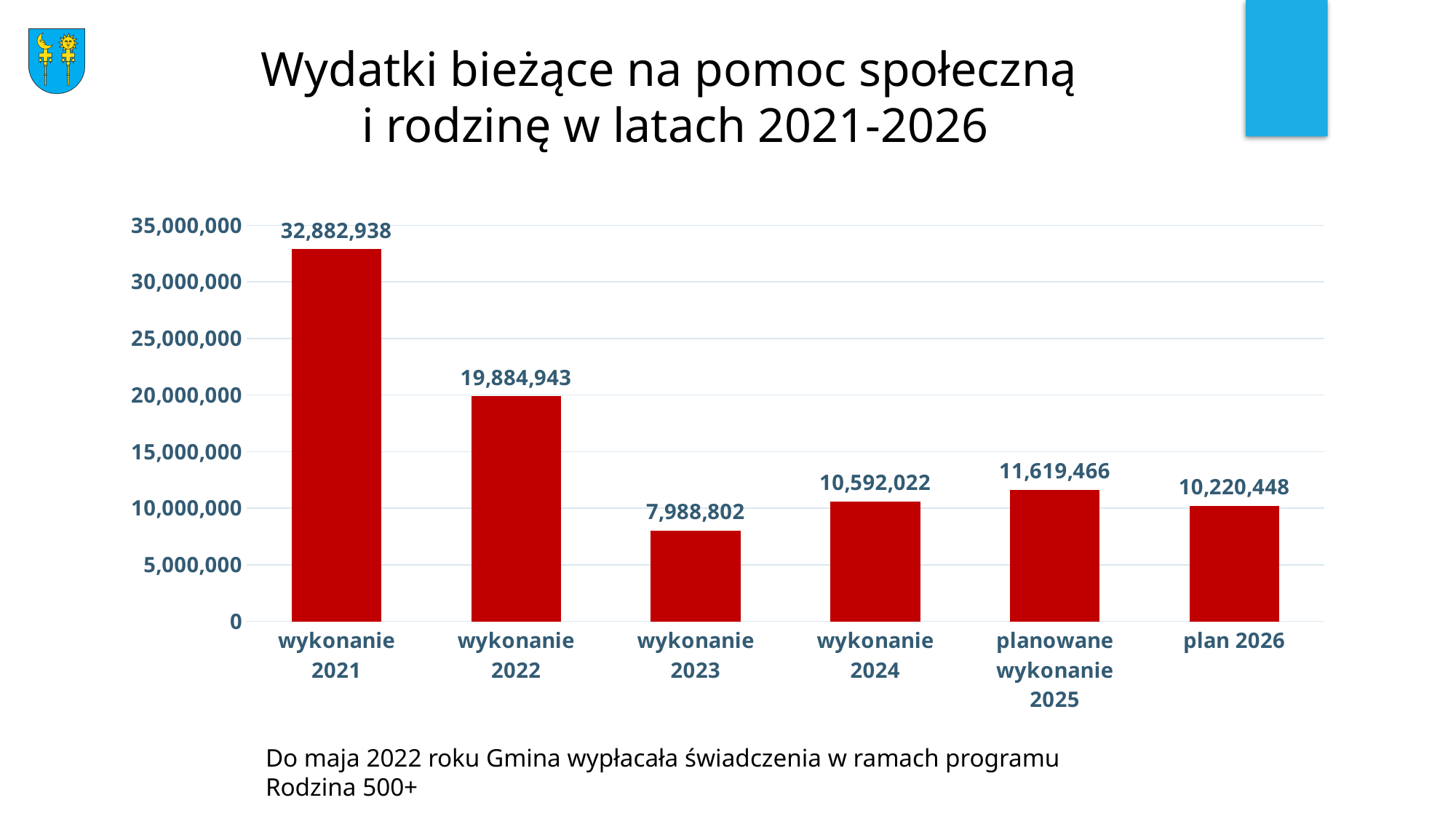
How many bars are shown in the chart? 6 Which category has the highest value? wykonanie 2021 What kind of chart is shown on the slide? bar chart Which category has the lowest value? wykonanie 2023 Which is larger, wykonanie 2024 or plan 2026? wykonanie 2024 Do the values rise or fall from wykonanie 2021 to wykonanie 2023? fall What is the difference between wykonanie 2021 and wykonanie 2022? 12,997,995 What is the difference between planowane wykonanie 2025 and wykonanie 2024? 1,027,444 What is the value for planowane wykonanie 2025? 11,619,466 What is the value for wykonanie 2021? 32,882,938 What is the value for wykonanie 2023? 7,988,802 What is the value for plan 2026? 10,220,448